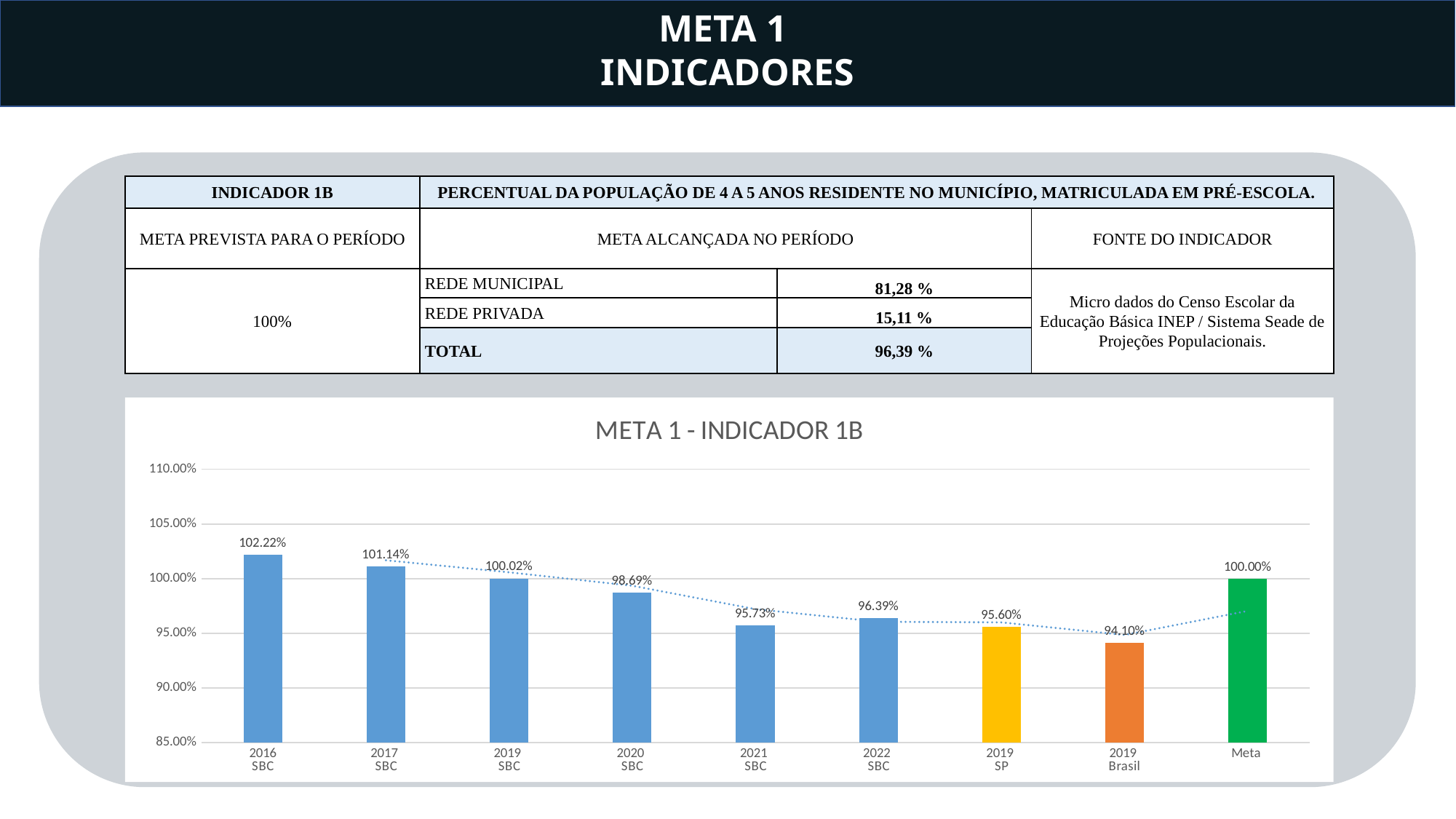
How many bars are shown in the chart? 9 Is the value for 2020 SBC greater or less than 100.00%? less What is the value of the Meta bar in the chart? 100.00% Which category has the highest value in the chart? 2016 SBC What kind of chart is shown on the slide? bar chart Which category has the lowest value in the chart? 2019 Brasil What is the value for 2016 SBC in the chart? 102.22% What is the difference between the values for 2016 SBC and 2017 SBC? 1.08% Which is larger, the value for 2021 SBC or the value for 2022 SBC? 2022 SBC What is the value for 2019 Brasil in the chart? 94.10% What is the value for 2022 SBC in the chart? 96.39% What is the title of the chart? META 1 - INDICADOR 1B